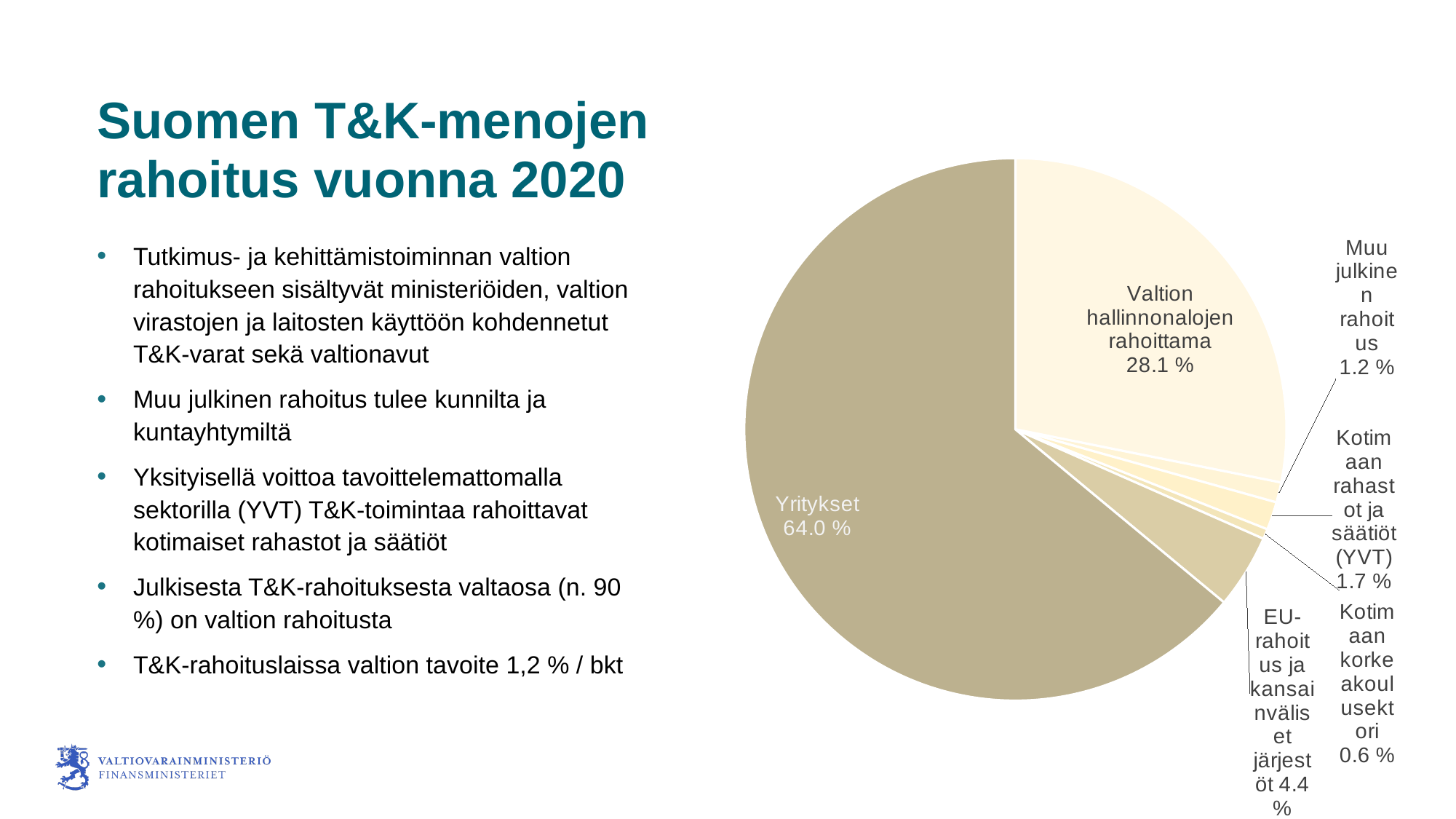
What share of the pie does Yritykset have? 64.0 % What is the value shown for Kotimaan korkeakoulusektori? 0.6 % What is the value shown for EU-rahoitus ja kansainväliset järjestöt? 4.4 % What is the value shown for Kotimaan rahastot ja säätiöt (YVT)? 1.7 % Which slice of the pie is the smallest? Kotimaan korkeakoulusektori Which slice of the pie is the largest? Yritykset How many slices does the pie chart have? 6 What is the value shown for Muu julkinen rahoitus? 1.2 % What kind of chart is shown on the slide? Pie chart What is the difference between the shares of Yritykset and Valtion hallinnonalojen rahoittama? 35.9 % Which is larger, the share of Muu julkinen rahoitus or the share of Kotimaan rahastot ja säätiöt (YVT)? Kotimaan rahastot ja säätiöt (YVT) What is the value shown for Valtion hallinnonalojen rahoittama? 28.1 %